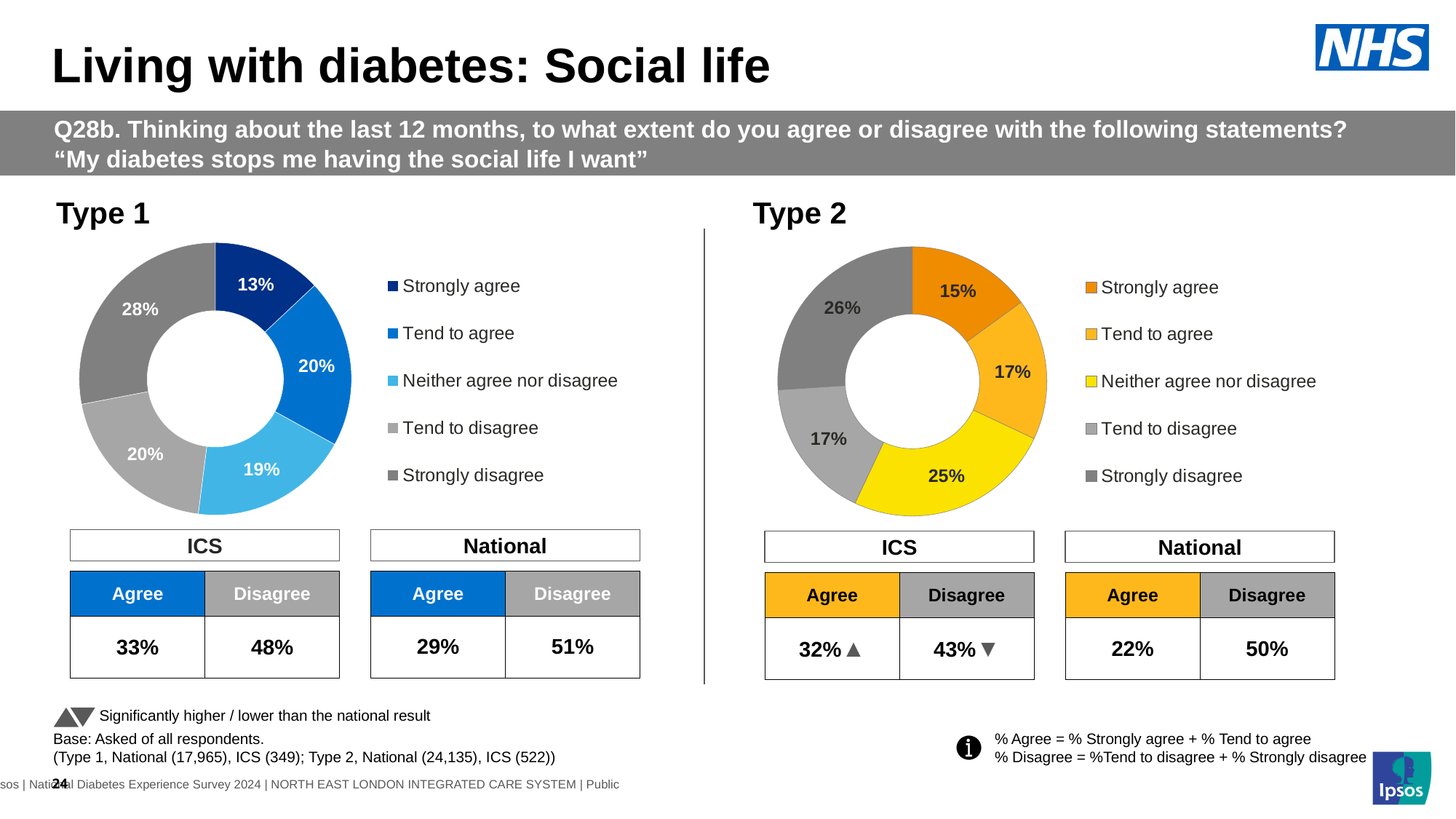
In the Type 2 chart, which is larger: the 'Neither agree nor disagree' share or the 'Strongly agree' share? Neither agree nor disagree In the Type 1 chart, what percentage of respondents said 'Strongly agree'? 13% In the Type 2 chart, what percentage of respondents said 'Neither agree nor disagree'? 25% In the Type 1 chart, which response category has the largest share? Strongly disagree In the Type 1 chart, which response category has the smallest share? Strongly agree In the Type 1 chart, what is the difference between the 'Strongly disagree' share and the 'Strongly agree' share? 15 percentage points In the Type 1 chart, what percentage of respondents said 'Strongly disagree'? 28% In the Type 2 chart, which response category has the largest share? Strongly disagree What kind of chart is used to show the Type 2 results? Donut (pie) chart In the Type 2 chart, which response category has the smallest share? Strongly agree How many response categories does the legend of the Type 1 chart list? 5 In the Type 2 chart, what percentage of respondents said 'Tend to agree'? 17%